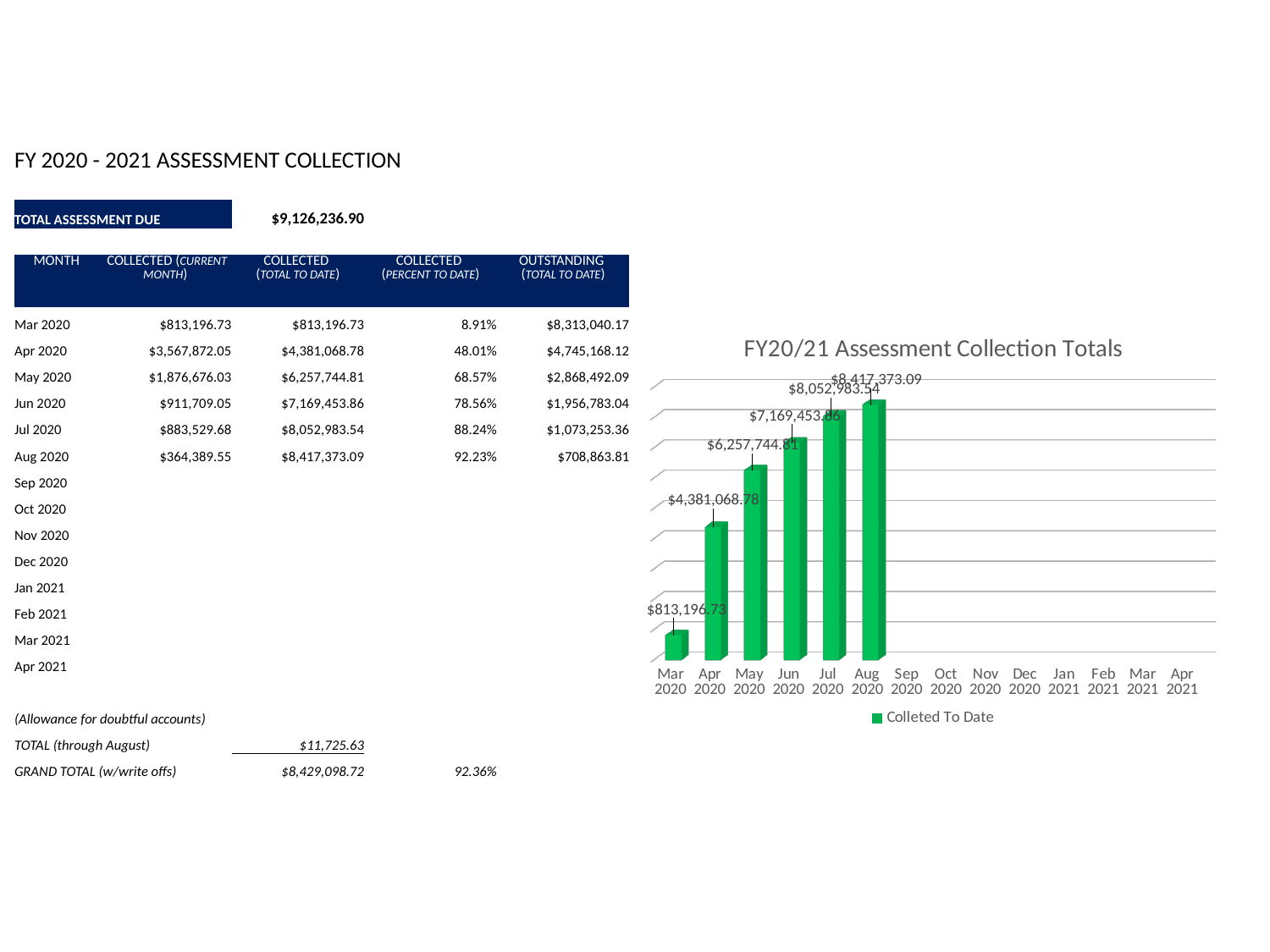
Do the bar values rise or fall from Mar 2020 to Aug 2020 in the chart? Rise What is the title of the chart? FY20/21 Assessment Collection Totals Which month has the highest bar in the chart? Aug 2020 What is the value of the bar for Jun 2020 in the chart? $7,169,453.86 What is the value of the bar for Apr 2020 in the chart? $4,381,068.78 How many month categories are shown on the x axis of the chart? 14 How many series does the chart legend list? 1 What is the value of the bar for Aug 2020 in the chart? $8,417,373.09 Which month has the lowest non-empty bar in the chart? Mar 2020 What is the difference between the Aug 2020 and Jul 2020 values in the chart? $364,389.55 What type of chart is shown on the slide? Bar chart What is the value of the bar for Mar 2020 in the chart? $813,196.73